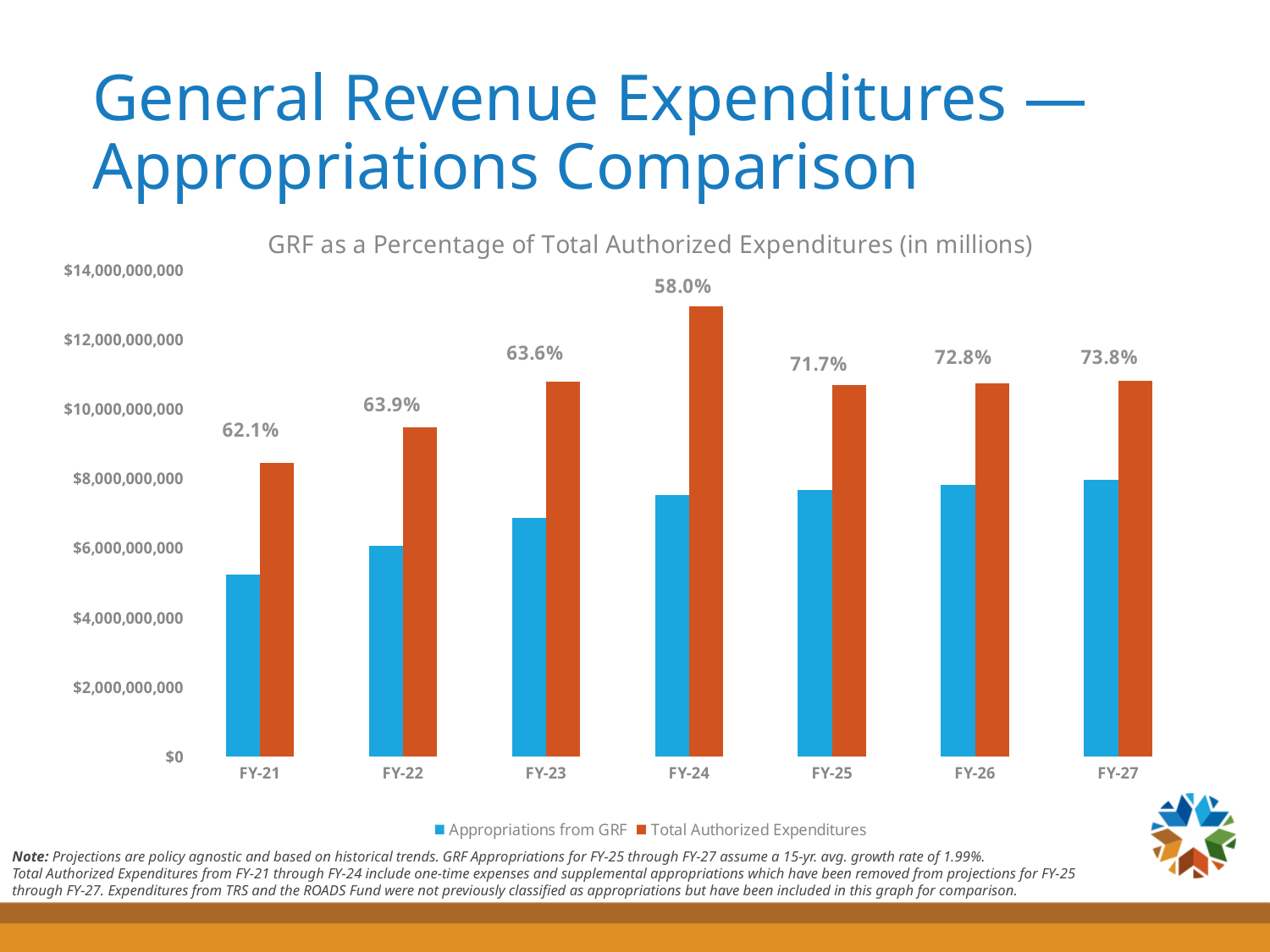
Is the Appropriations from GRF bar for FY-21 greater or less than $6,000,000,000? less Do the Appropriations from GRF bars rise or fall from FY-21 to FY-27? rise Which fiscal year has the highest GRF percentage label? FY-27 How many fiscal years are shown on the x axis? 7 What percentage label is shown above the FY-21 bars? 62.1% Is the Total Authorized Expenditures bar for FY-24 greater or less than $12,000,000,000? greater Which is larger: Total Authorized Expenditures for FY-24 or for FY-23? FY-24 What percentage label is shown above the FY-27 bars? 73.8% What is the difference in percentage points between the FY-27 label (73.8%) and the FY-21 label (62.1%)? 11.7 percentage points Which fiscal year has the lowest GRF percentage label? FY-24 How many series does the legend list? 2 What percentage label is shown above the FY-24 bars? 58.0%